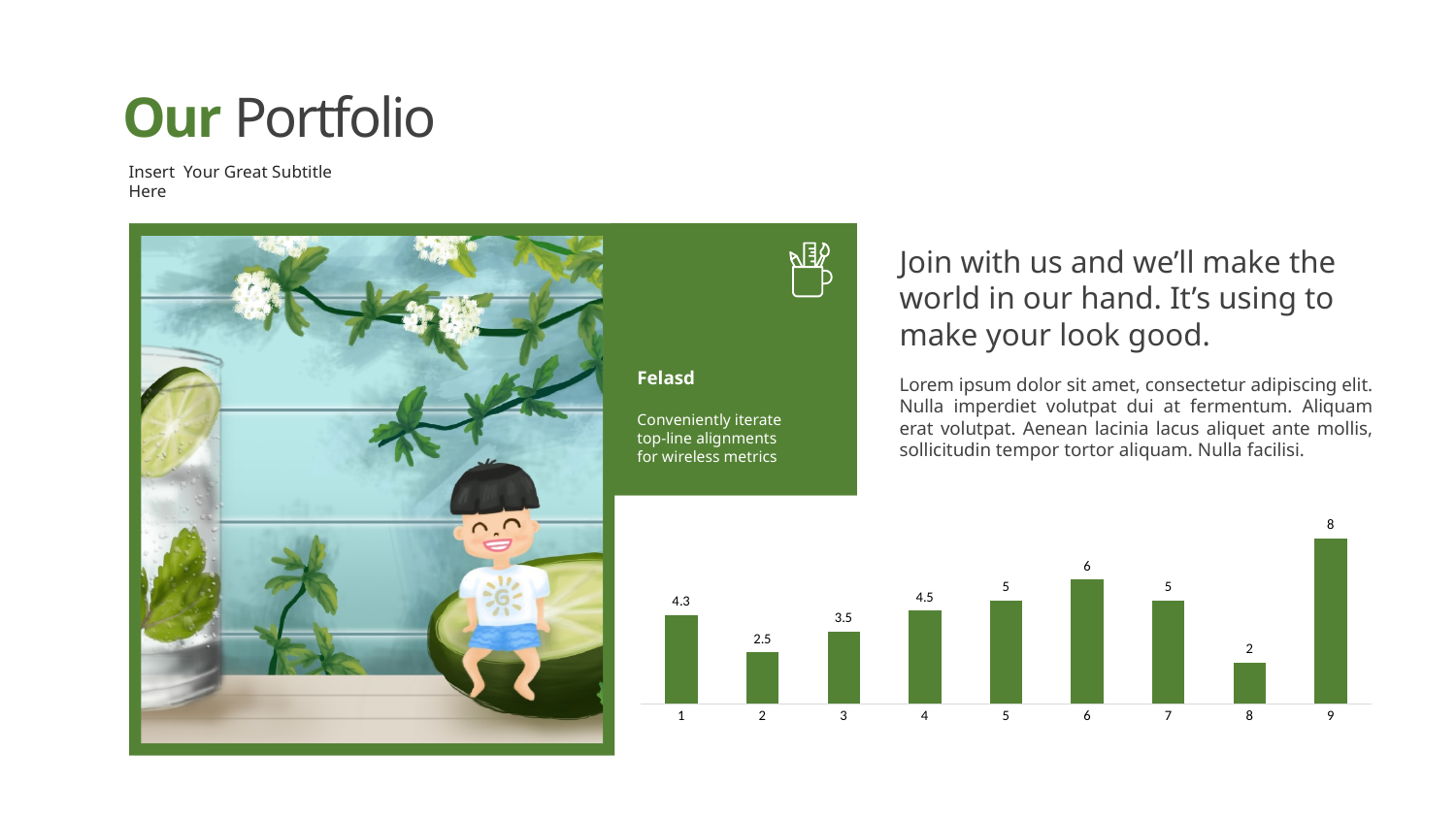
Which category has the lowest value in the bar chart? 8 Do the values rise or fall from category 2 to category 6? rise What kind of chart is shown on the slide? bar chart What is the difference between the values for category 9 and category 6? 2 What is the value for category 8 in the bar chart? 2 What is the value for category 1 in the bar chart? 4.3 What is the difference between the values for category 1 and category 2? 1.8 What is the value for category 4 in the bar chart? 4.5 How many bars are plotted in the chart? 9 Which category has the highest value in the bar chart? 9 Which is larger, the value for category 3 or the value for category 5? category 5 What colour are the bars in the chart? green